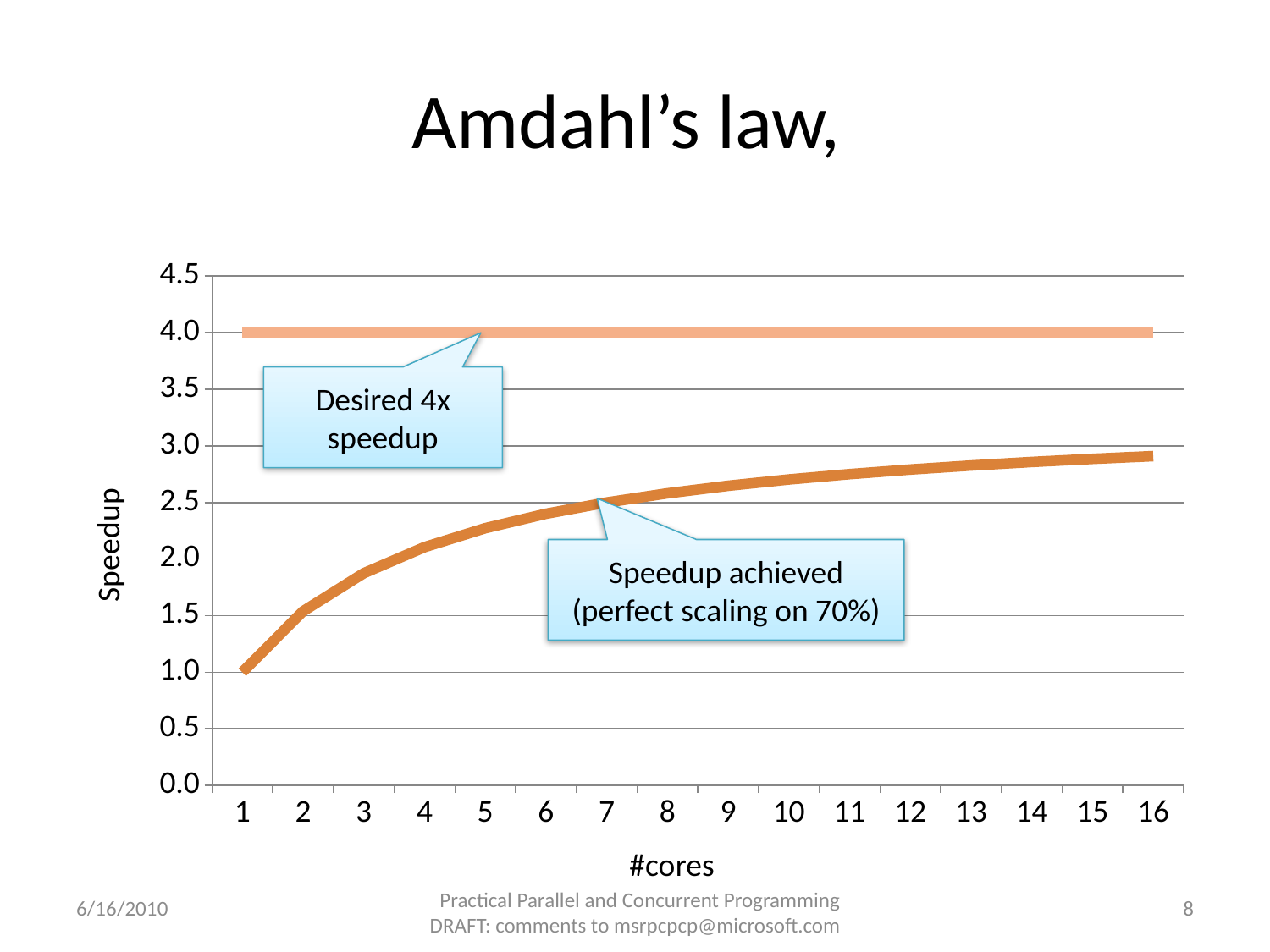
What is the label of the x axis? #cores Is the speedup achieved at 16 cores greater or less than 2.5? greater What is the speedup achieved at 1 core? 1.0 What kind of chart is shown on the slide? line chart Is the speedup achieved at 16 cores greater or less than 3.0? less How many core counts are shown along the x axis? 16 What is the value of the 'Desired 4x speedup' line? 4.0 At 16 cores, which is higher: the desired speedup or the speedup achieved? desired speedup Does the 'Speedup achieved' curve rise or fall as the number of cores increases? rises At which number of cores is the speedup achieved lowest? 1 Is the speedup achieved at 3 cores greater or less than 1.5? greater At which number of cores is the speedup achieved highest? 16